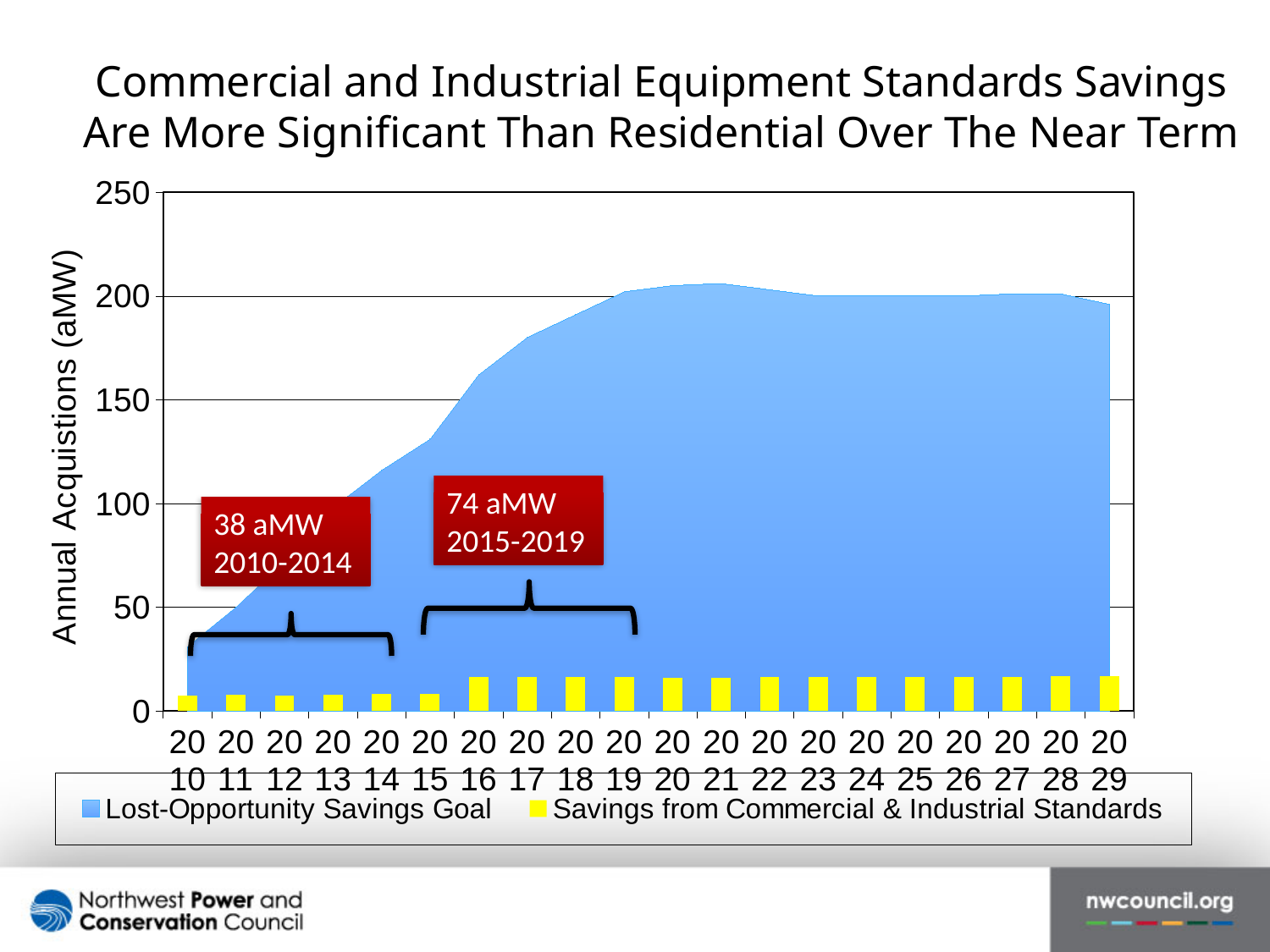
In 2025, which series has the larger value: Lost-Opportunity Savings Goal or Savings from Commercial & Industrial Standards? Lost-Opportunity Savings Goal Is the Lost-Opportunity Savings Goal for 2010 greater or less than 50? less What kind of chart is used to plot the Lost-Opportunity Savings Goal series? area chart Is the Lost-Opportunity Savings Goal for 2017 greater or less than 150? greater Does the Lost-Opportunity Savings Goal rise or fall from 2010 to 2020? rise According to the annotation, how much savings is attributed to the 2010-2014 period? 38 aMW Is the value for Savings from Commercial & Industrial Standards in 2016 greater or less than 50? less How many years are shown along the x axis? 20 According to the annotation, how much savings is attributed to the 2015-2019 period? 74 aMW What are the two series named in the legend? Lost-Opportunity Savings Goal; Savings from Commercial & Industrial Standards How many series does the legend list? 2 What is the y-axis label of the chart? Annual Acquistions (aMW)